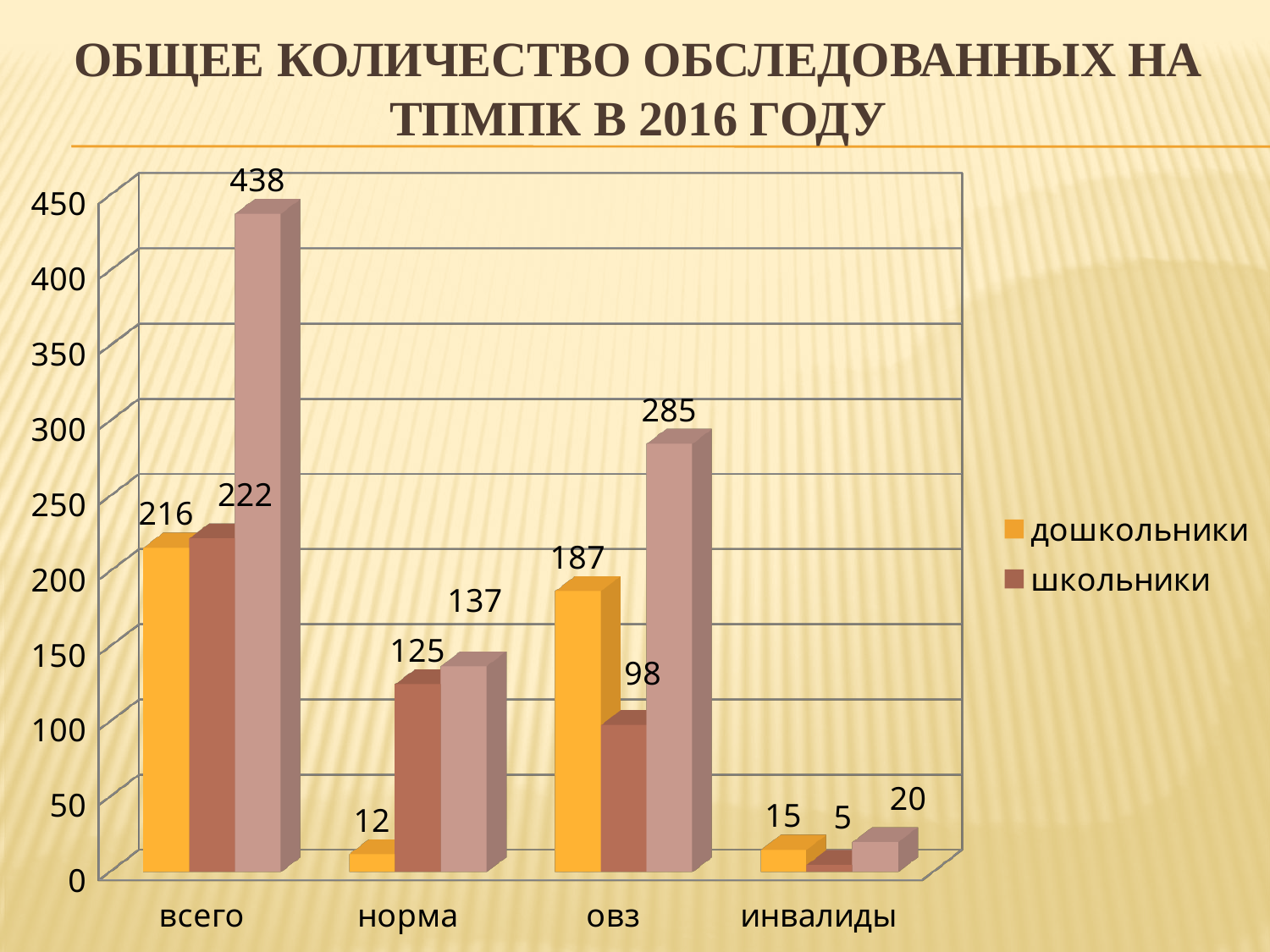
How many categories are shown on the x axis? 4 What is the value for школьники in the норма category? 125 In the норма category, which is larger: дошкольники or школьники? школьники What is the value for дошкольники in the овз category? 187 What is the difference between the школьники and дошкольники values in the всего category? 6 What is the value for дошкольники in the всего category? 216 What kind of chart is shown on the slide? bar chart In which category is the школьники value lowest? инвалиды What is the value for школьники in the инвалиды category? 5 In which category is the дошкольники value highest? всего How many series does the legend list? 2 By how much does the дошкольники value exceed the школьники value in the овз category? 89